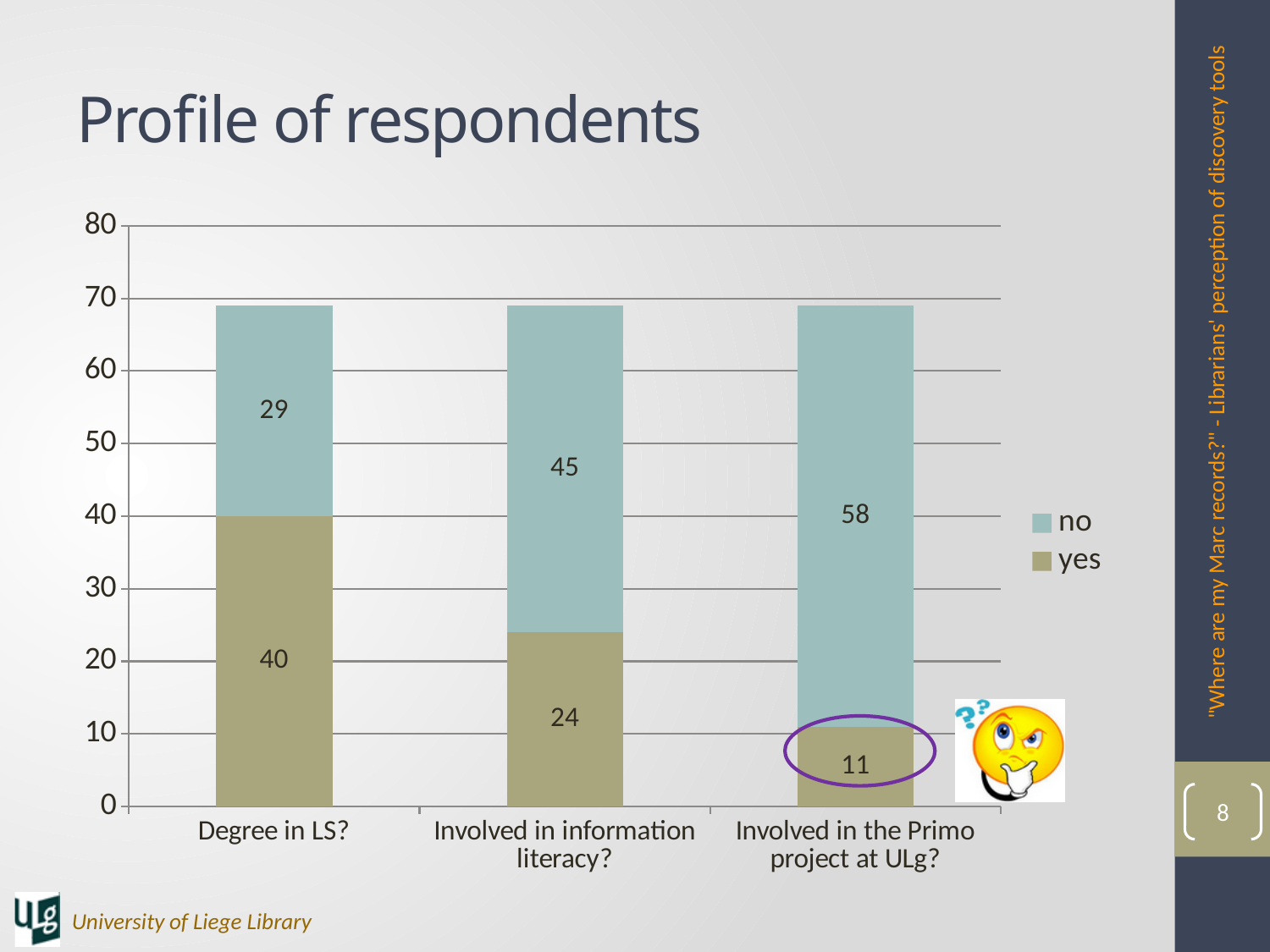
What is the total of the stacked bar for 'Degree in LS?'? 69 What is the difference between the 'no' and 'yes' values for 'Involved in the Primo project at ULg?'? 47 Which is larger for 'Involved in information literacy?': the 'yes' value or the 'no' value? no How many categories are shown on the x axis? 3 What is the 'no' value for 'Involved in the Primo project at ULg?'? 58 What is the 'no' value for 'Involved in information literacy?'? 45 Which category has the lowest 'no' value? Degree in LS? How many series does the legend list? 2 What is the 'yes' value for 'Degree in LS?'? 40 What kind of chart is shown on the slide? Stacked bar chart What is the 'yes' value for 'Involved in the Primo project at ULg?'? 11 Which category has the highest 'yes' value? Degree in LS?